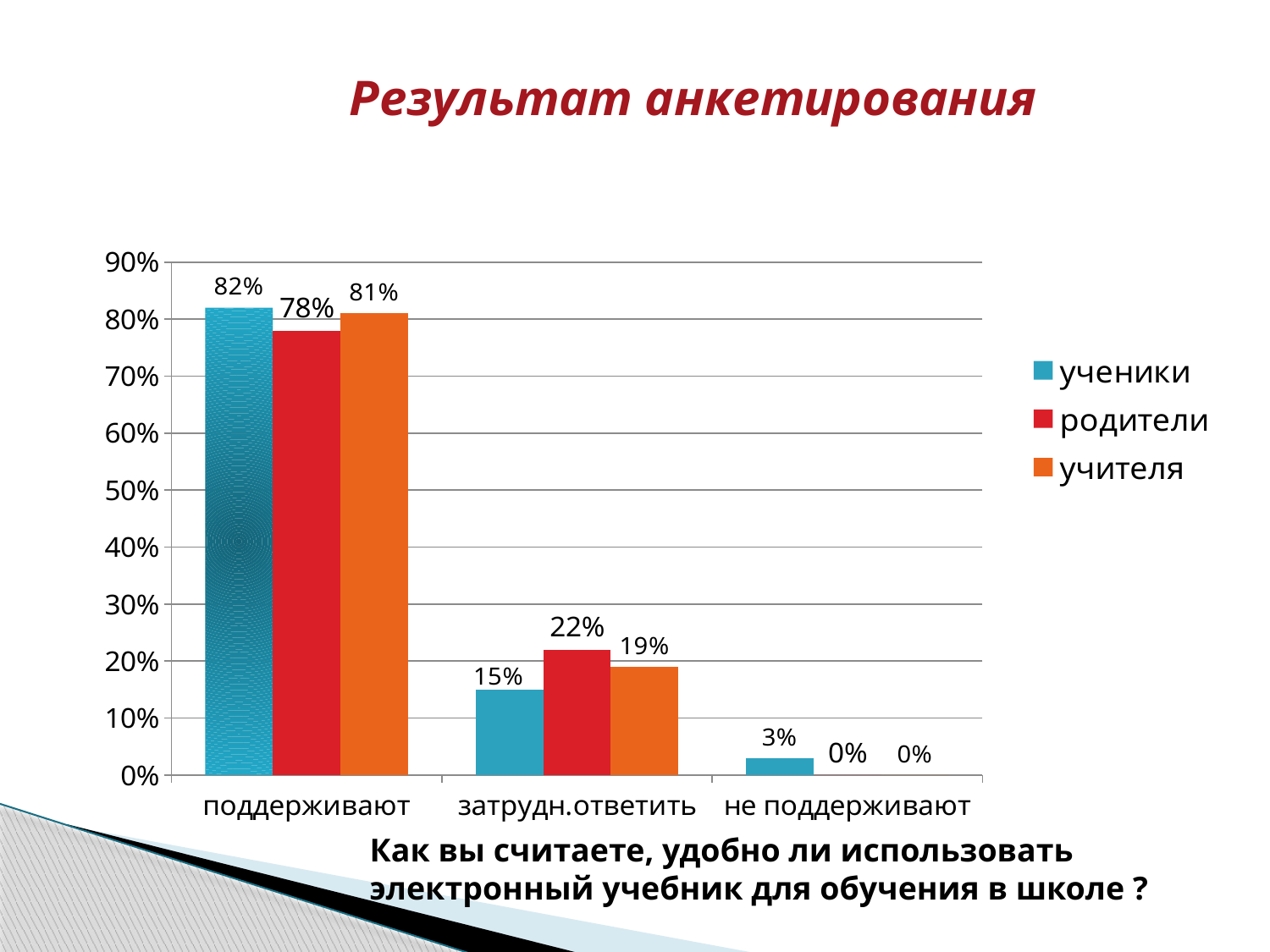
What colour represents the родители series? red What is the value for родители in the затрудн.ответить category? 22% What is the value for ученики in the поддерживают category? 82% How many categories are shown on the x axis? 3 Is the value for родители in the затрудн.ответить category greater or less than 20%? greater Which series has the lowest value in the затрудн.ответить category? ученики What is the difference between the ученики and родители values in the поддерживают category? 4% What is the value for учителя in the не поддерживают category? 0% Which is larger: the учителя value for поддерживают or the родители value for поддерживают? учителя What kind of chart is shown on the slide? bar chart How many series does the legend list? 3 Which series has the highest value in the поддерживают category? ученики